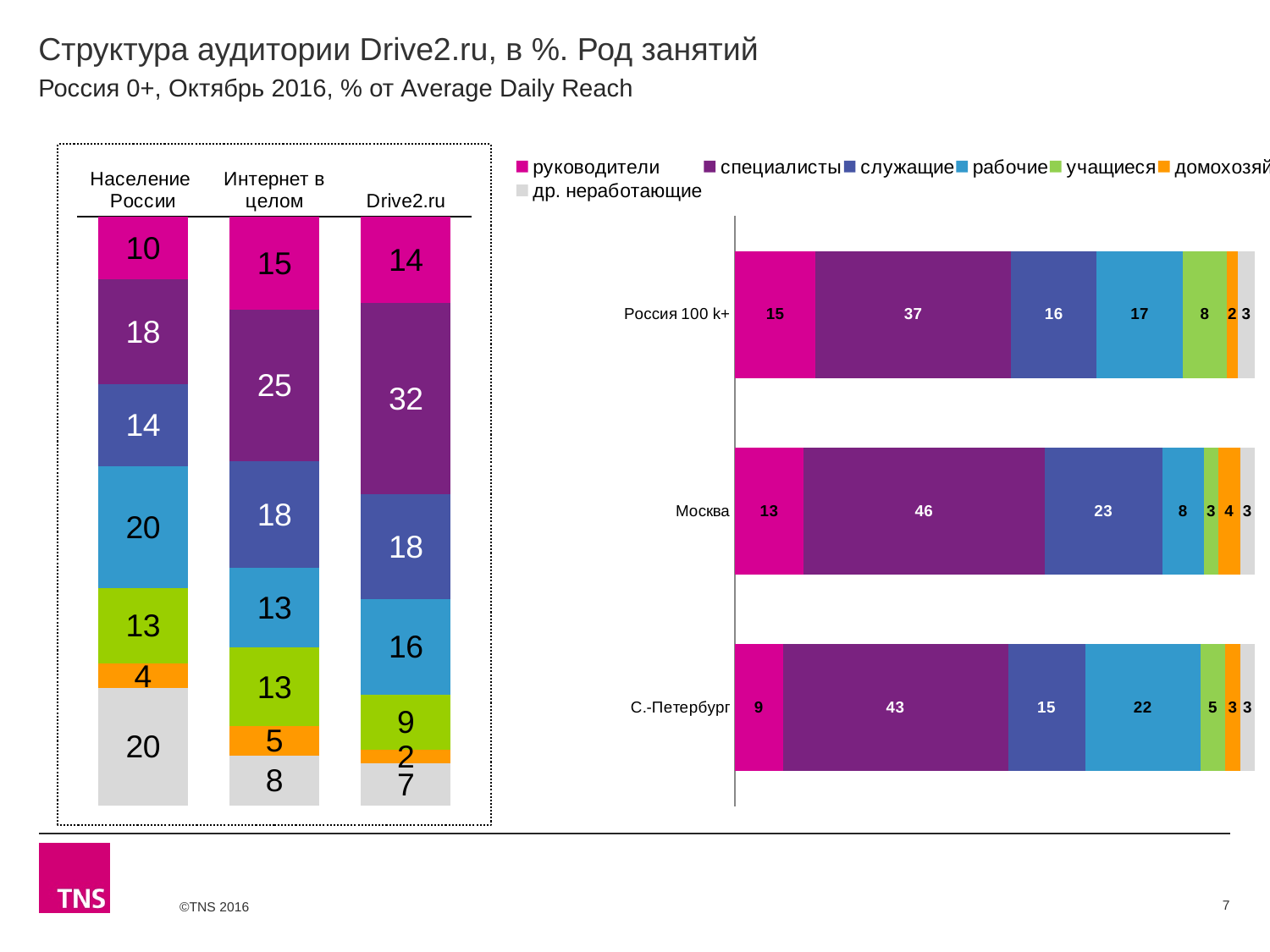
How many series does the legend of the right chart list? 7 On the right chart, which is larger: the руководители value for Россия 100 k+ or for С.-Петербург? Россия 100 k+ What kind of chart is the left chart? Stacked bar chart How many regions are shown on the right chart? 3 On the right chart, what is the difference between the специалисты values for Москва and Россия 100 k+? 9 On the right chart, which region has the highest value for специалисты? Москва On the right chart, what is the value for рабочие in С.-Петербург? 22 On the right chart, which region has the lowest value for руководители? С.-Петербург On the left chart, what is the value of the largest segment of the Drive2.ru bar? 32 On the right chart, what is the total of the Москва bar? 100 On the right chart, what is the value for специалисты in Москва? 46 On the left chart, what is the value of the top segment of the Интернет в целом bar? 15